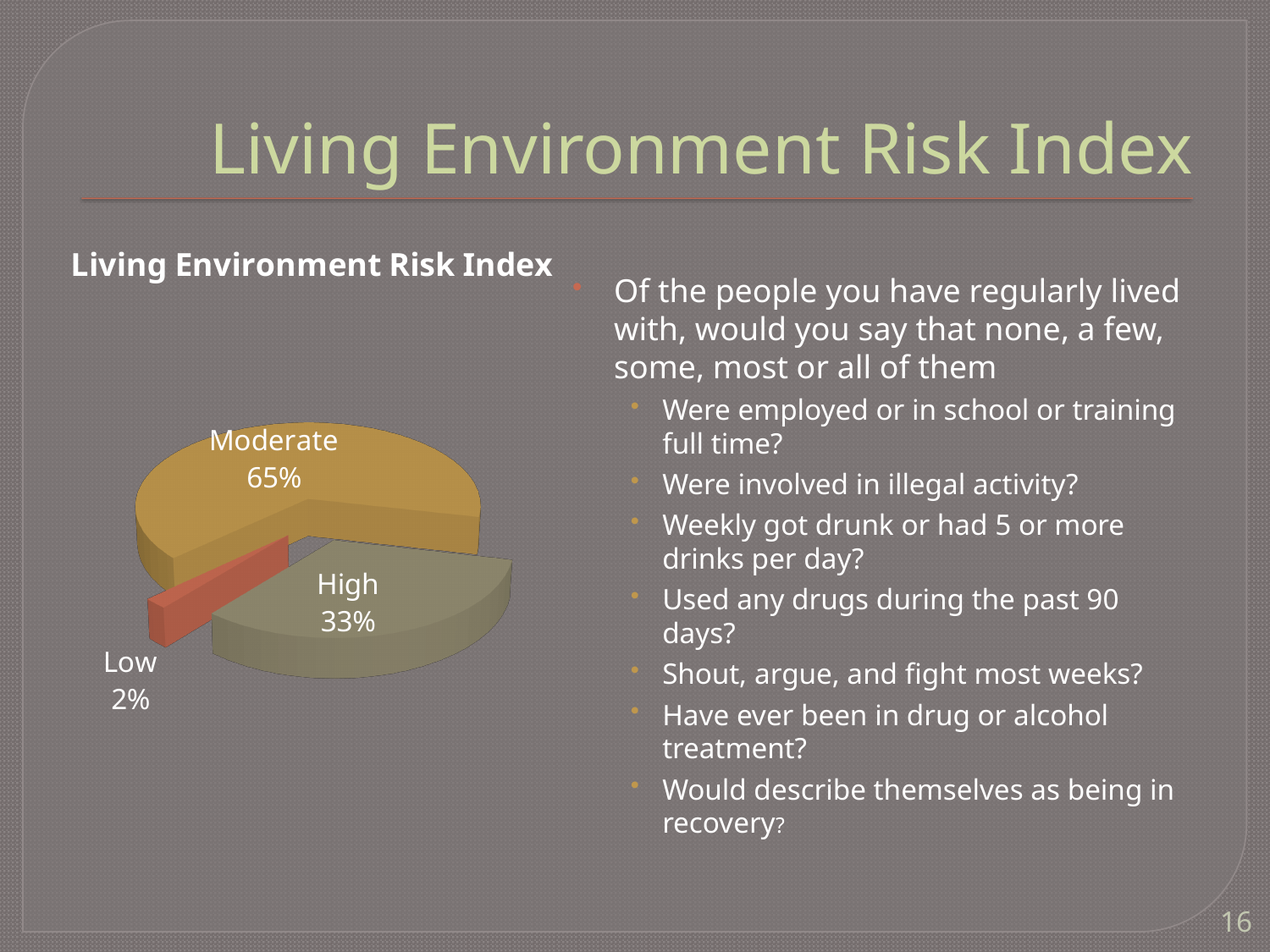
What percentage is shown for the Low slice? 2% What is the difference in percentage points between the Moderate and High slices? 32 How many slices does the pie chart have? 3 What percentage is shown for the Moderate slice? 65% What is the title of the chart? Living Environment Risk Index What kind of chart is shown on the slide? pie chart What share of the pie does the High category represent? 33% What percentage is shown for the High slice? 33% What colour is the Low slice? red Which category has the largest share of the pie? Moderate Which is larger, the High slice or the Low slice? High Which category has the smallest share of the pie? Low